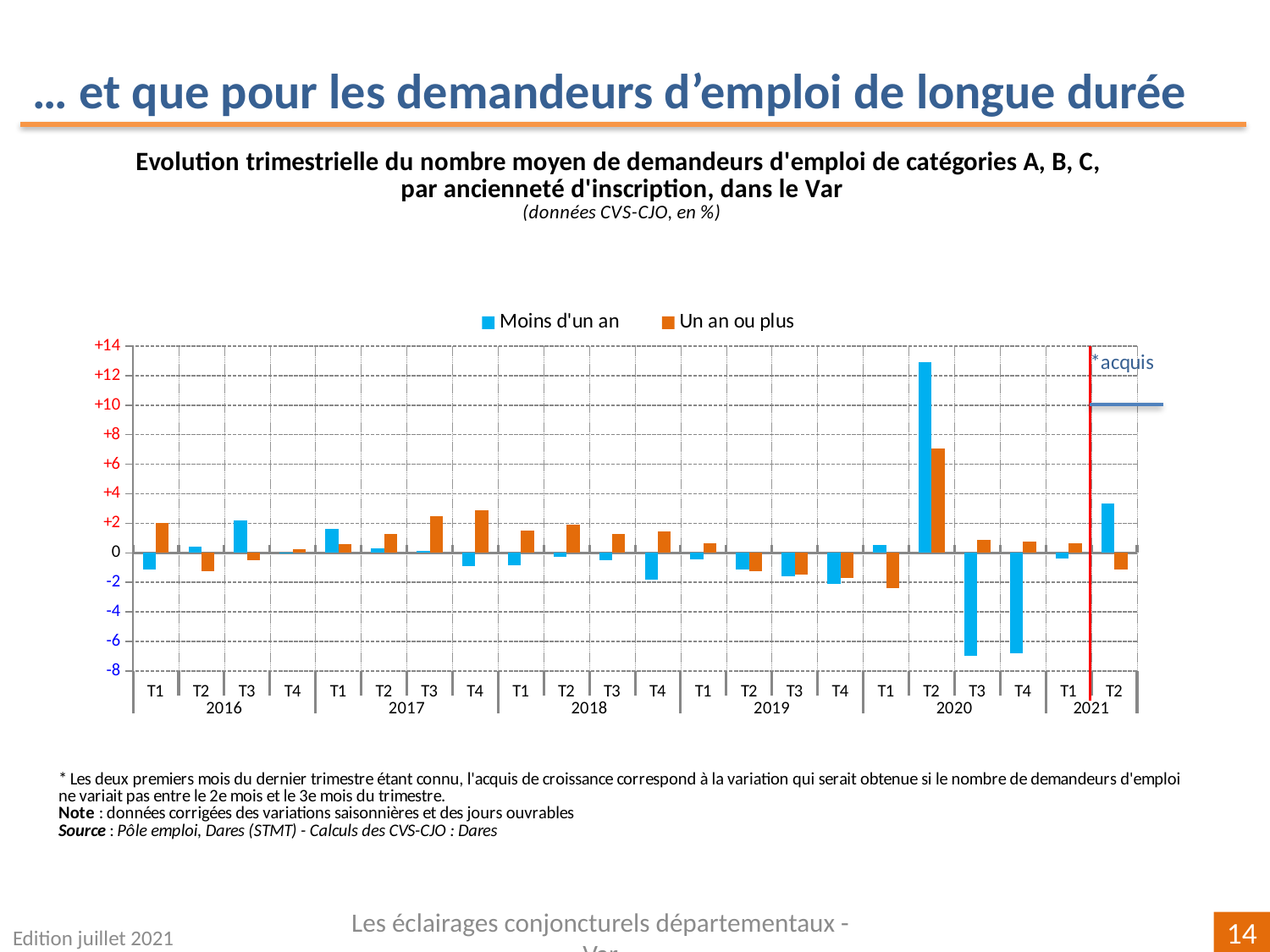
Is the value for 'Moins d'un an' in T3 2020 greater or less than -6? less In which quarter is the value for 'Un an ou plus' the highest? T2 2020 In T4 2017, which series has the larger value, 'Moins d'un an' or 'Un an ou plus'? Un an ou plus Is the value for 'Un an ou plus' in T2 2020 greater or less than +6? greater In which quarter is the value for 'Moins d'un an' the highest? T2 2020 In which quarter is the value for 'Un an ou plus' the lowest? T1 2020 Is the value for 'Moins d'un an' in T2 2020 greater or less than +10? greater What are the two series named in the legend? Moins d'un an; Un an ou plus What kind of chart is shown on the slide? bar chart How many series does the legend list? 2 In T2 2020, which series has the larger value, 'Moins d'un an' or 'Un an ou plus'? Moins d'un an How many quarters (bars per series) are plotted on the x axis? 22